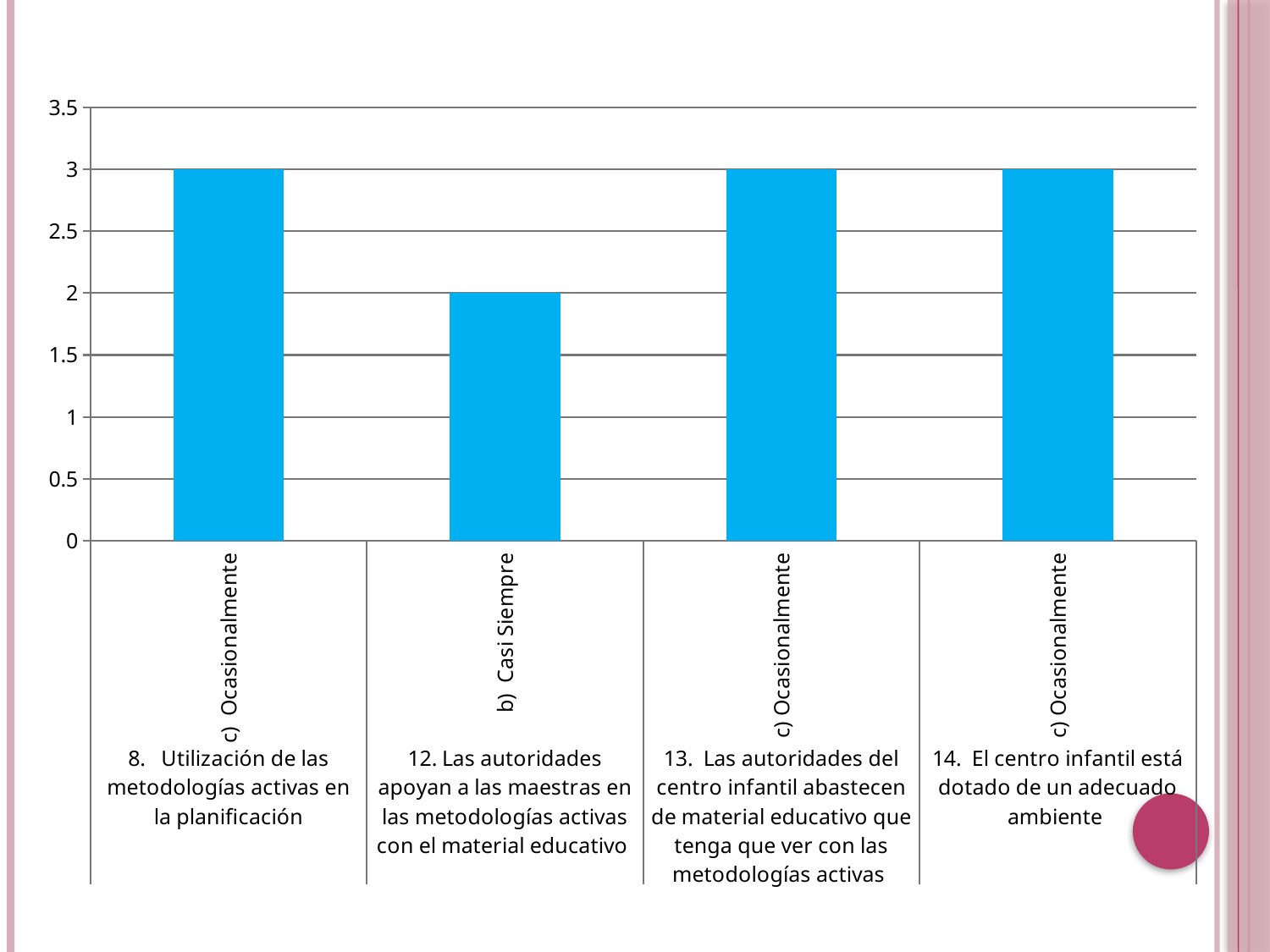
What is the difference between the value for item 13 and the value for item 12? 1 How many bars (categories) does the chart show? 4 What is the maximum value shown on the vertical axis? 3.5 Which item has the lowest value? 12. Las autoridades apoyan a las maestras en las metodologías activas con el material educativo What is the value for item 14 (El centro infantil está dotado de un adecuado ambiente)? 3 What type of chart is shown on the slide? bar chart What is the value for item 12 (Las autoridades apoyan a las maestras en las metodologías activas con el material educativo)? 2 What response option is shown for item 12? b) Casi Siempre What is the value for item 8 (Utilización de las metodologías activas en la planificación)? 3 Which has the larger value, item 8 or item 12? item 8 Is the value for item 12 greater or less than 2.5? less Is the value for item 13 greater or less than 2.5? greater